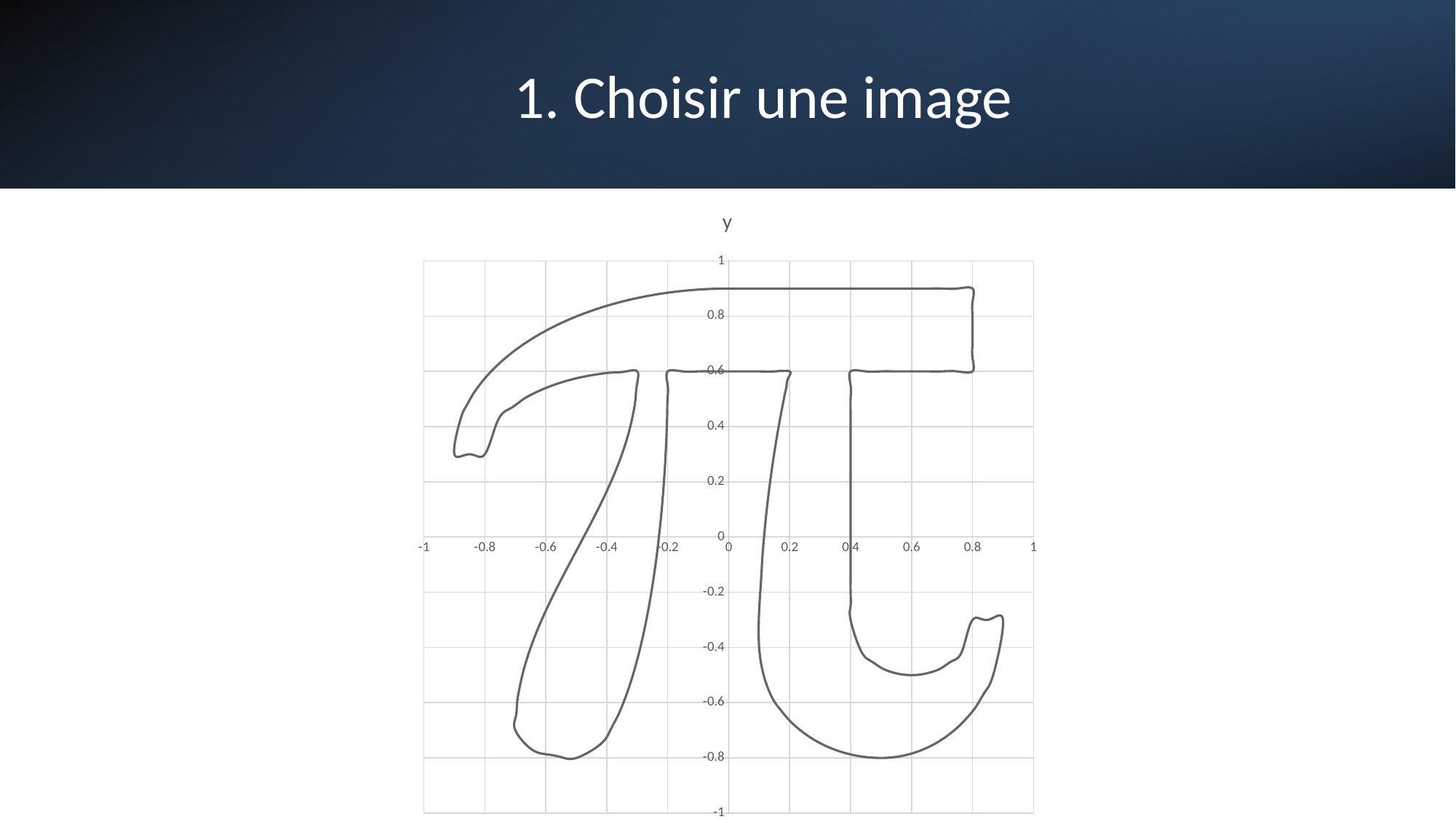
What symbol does the plotted outline on the chart depict? the Greek letter pi (π) What is the title shown above the vertical axis of the chart? y Is the smallest x value reached by the plotted outline greater or less than -0.6? less Is the lowest y value reached by the plotted outline greater or less than -0.6? less Is the highest y value reached by the plotted outline greater or less than 0.8? greater What kind of chart is shown on the slide? scatter (line) chart What is the maximum value shown on the horizontal axis of the chart? 1